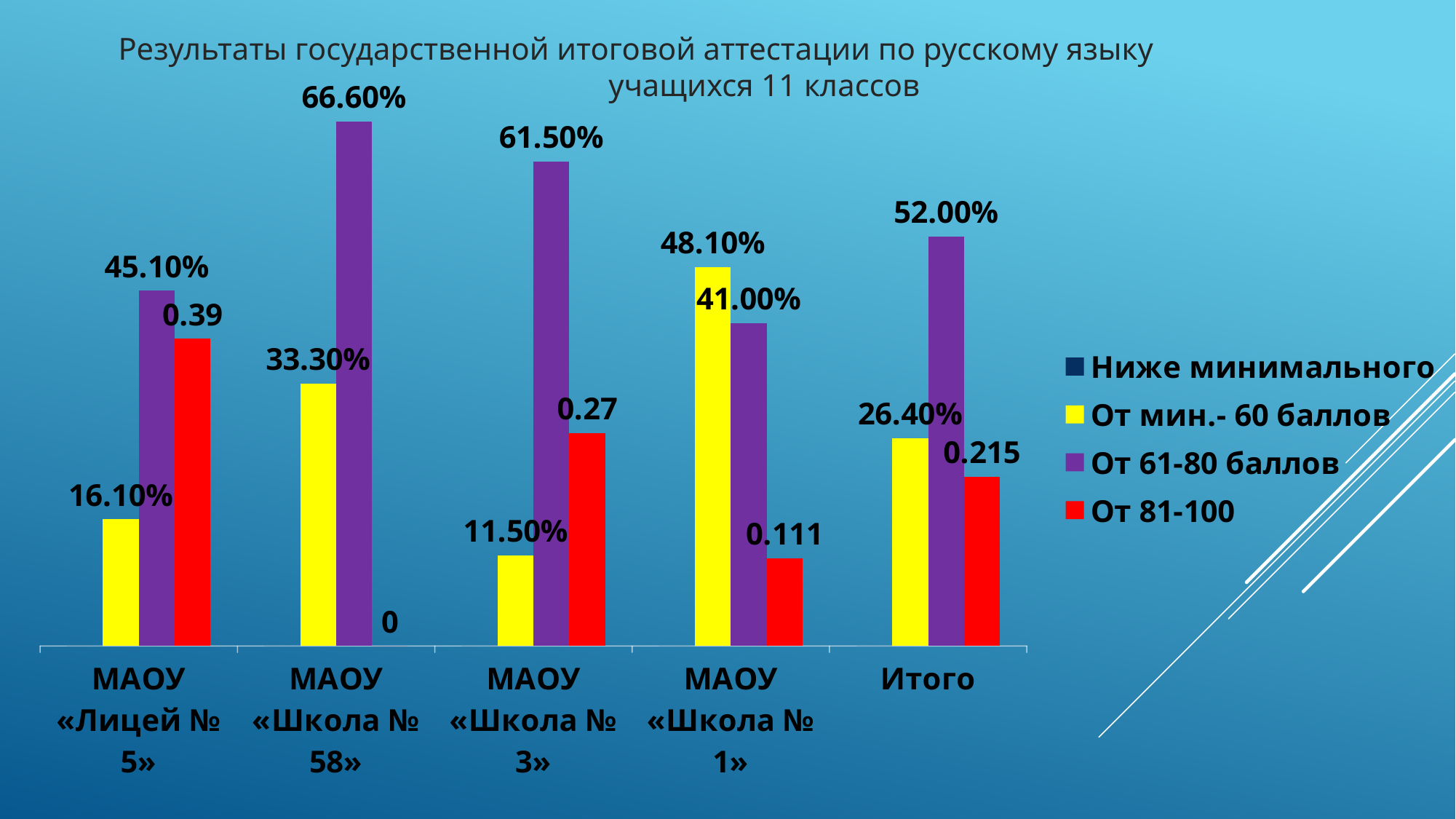
What is the value of «От мин.- 60 баллов» for МАОУ «Школа № 1»? 48.10% What is the value of «От 81-100» for МАОУ «Лицей № 5»? 0.39 What is the value of «От 81-100» for Итого? 0.215 What is the value of «От 61-80 баллов» for МАОУ «Школа № 58»? 66.60% For МАОУ «Школа № 1», which is larger: «От мин.- 60 баллов» or «От 61-80 баллов»? От мин.- 60 баллов What kind of chart is shown on the slide? Bar chart Which category has the lowest value for «От мин.- 60 баллов»? МАОУ «Школа № 3» What is the difference between the «От 61-80 баллов» values for МАОУ «Школа № 58» and МАОУ «Школа № 3»? 5.10% Which colour represents the «От 81-100» series? Red How many series does the legend list? 4 How many categories are shown on the x axis? 5 Which category has the highest value for «От 61-80 баллов»? МАОУ «Школа № 58»